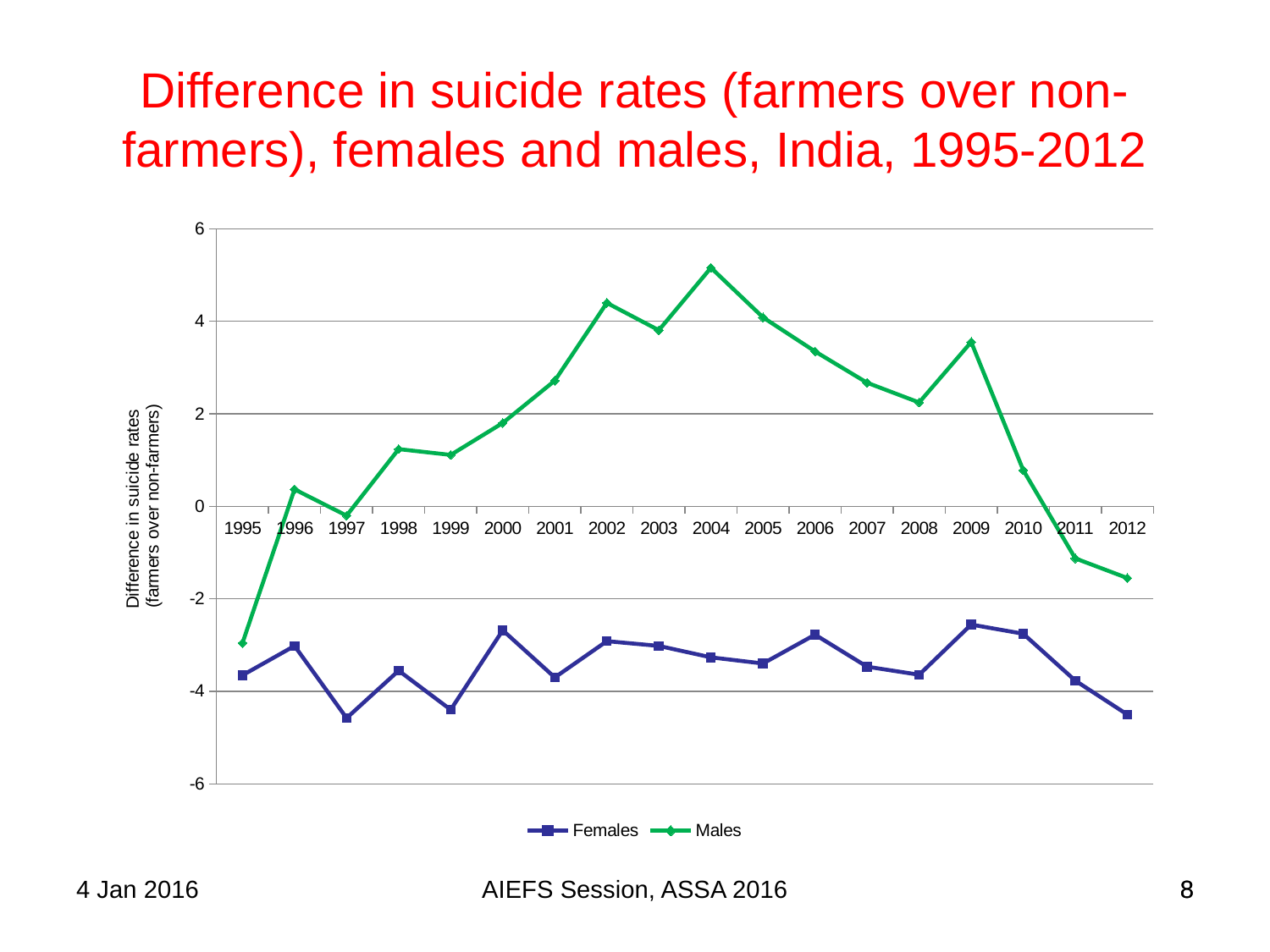
In which year is the Males series at its lowest? 1995 Is the value for Males in 2009 greater or less than 2? greater Is the value for Males in 2004 greater or less than 4? greater Which series has the larger value in 2004, Females or Males? Males Does the Males series rise or fall from 2009 to 2012? Fall Is the value for Males in 2012 greater or less than 0? less What kind of chart is shown on the slide? Line chart In which year is the Males series at its highest? 2004 How many series does the legend list? 2 How many years are plotted along the x axis? 18 What are the two entries in the legend? Females and Males